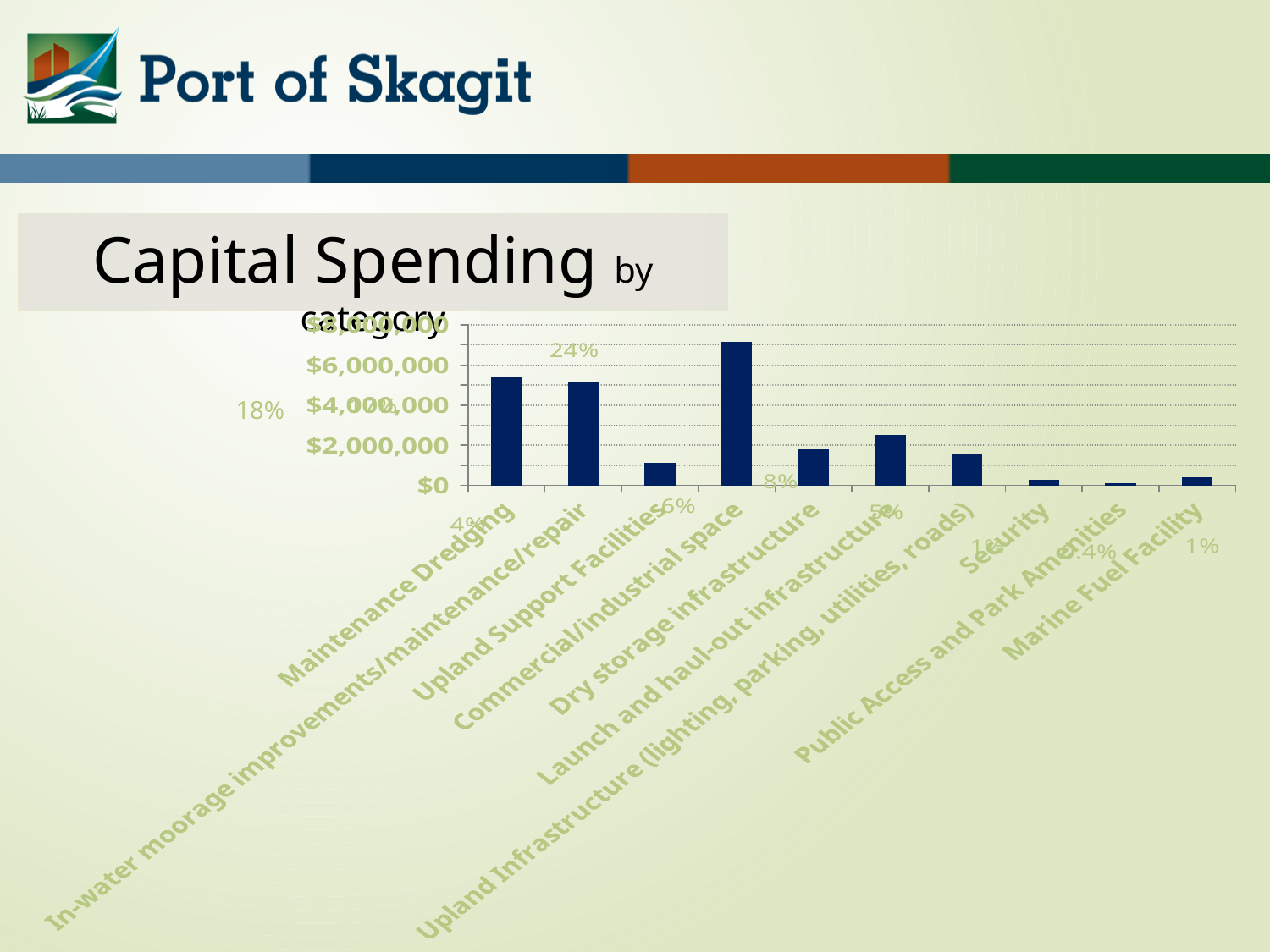
Is the value for Maintenance Dredging greater or less than $6,000,000? less Is the value for Upland Support Facilities greater or less than $2,000,000? less How many categories are plotted in the Capital Spending by category chart? 10 Is the value for Security greater or less than $2,000,000? less Which is larger, the value for Launch and haul-out infrastructure or the value for Dry storage infrastructure? Launch and haul-out infrastructure Which is larger, the value for Commercial/industrial space or the value for Maintenance Dredging? Commercial/industrial space What kind of chart is shown on the slide? bar chart Which category has the highest capital spending? Commercial/industrial space What is the title of the chart on the slide? Capital Spending by category